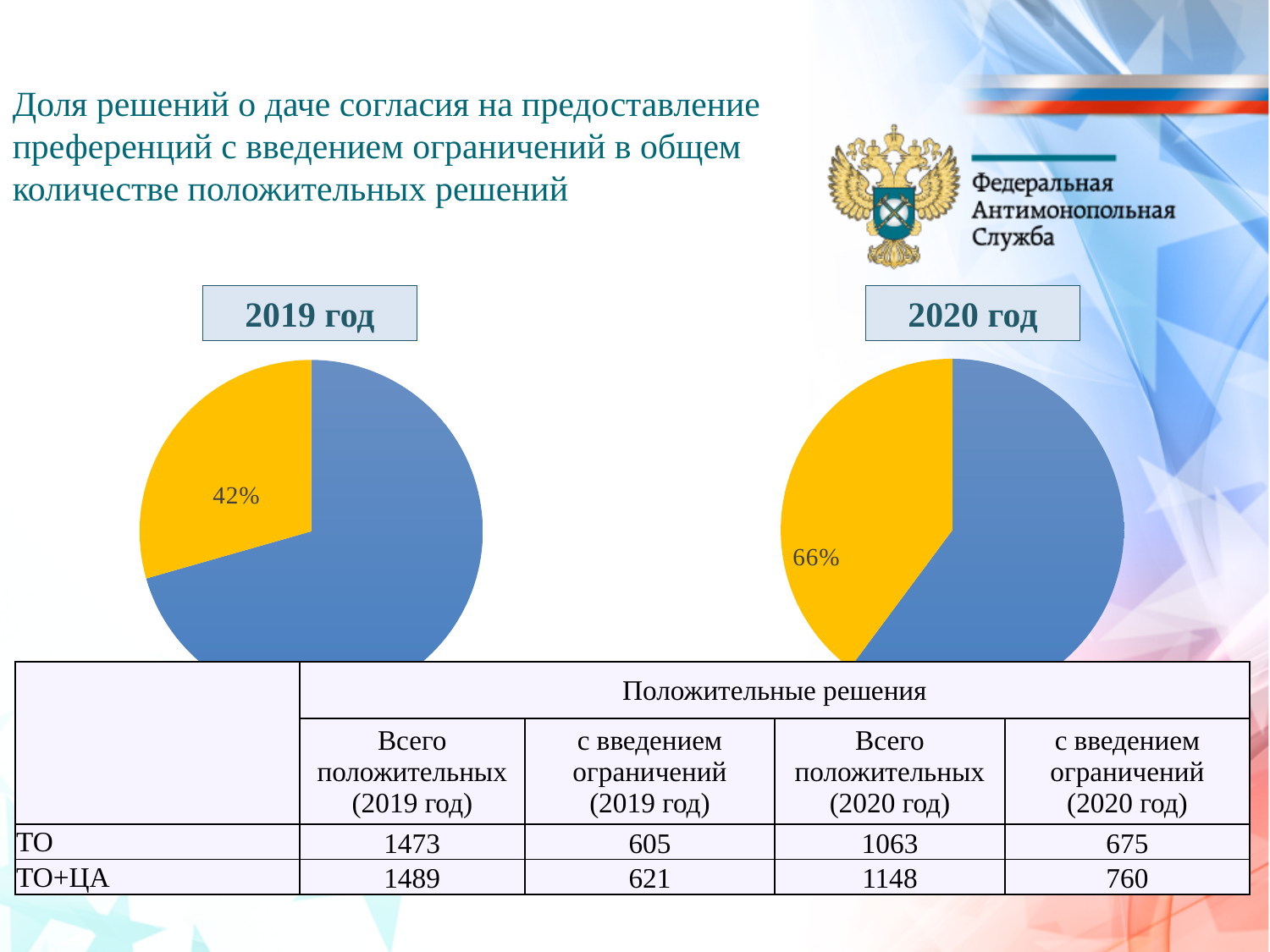
What type of chart is used for "2019 год"? Pie chart Is the labelled slice in the "2019 год" pie chart greater or less than 50%? less How many slices does the "2020 год" pie chart have? 2 Which pie chart has the larger labelled slice, "2019 год" or "2020 год"? 2020 год How many pie charts are shown on the slide? 2 In the "2020 год" pie chart, which slice is larger, the yellow one or the blue one? The blue one By how many percentage points does the labelled slice in the "2020 год" pie chart exceed the labelled slice in the "2019 год" pie chart? 24 percentage points In the "2019 год" pie chart, what percentage is shown on the labelled slice? 42% What colour is the slice labelled 42% in the "2019 год" pie chart? Yellow In the "2020 год" pie chart, what percentage is shown on the labelled slice? 66% In the "2019 год" pie chart, which slice is larger, the yellow one or the blue one? The blue one